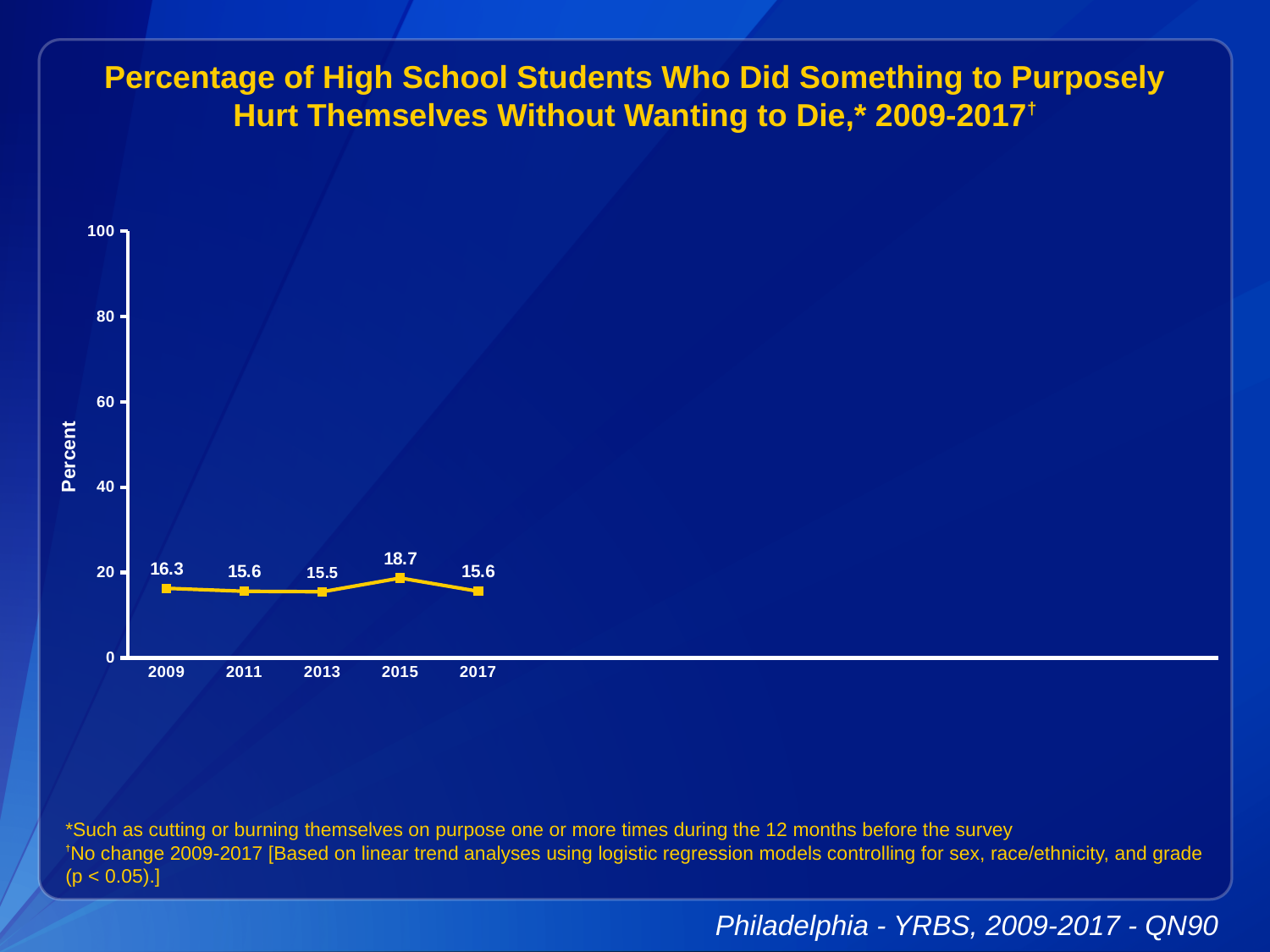
Which is larger, the value for 2009 or the value for 2017? 2009 Which year has the highest value? 2015 What is the value for 2009? 16.3 How many years are plotted on the chart? 5 Is the value for 2015 greater or less than 20? less What is the label of the y axis? Percent Which year has the lowest value? 2013 What is the value for 2015? 18.7 What is the difference between the values for 2015 and 2009? 2.4 What kind of chart is shown on the slide? line chart What is the maximum value shown on the y axis? 100 What is the value for 2013? 15.5